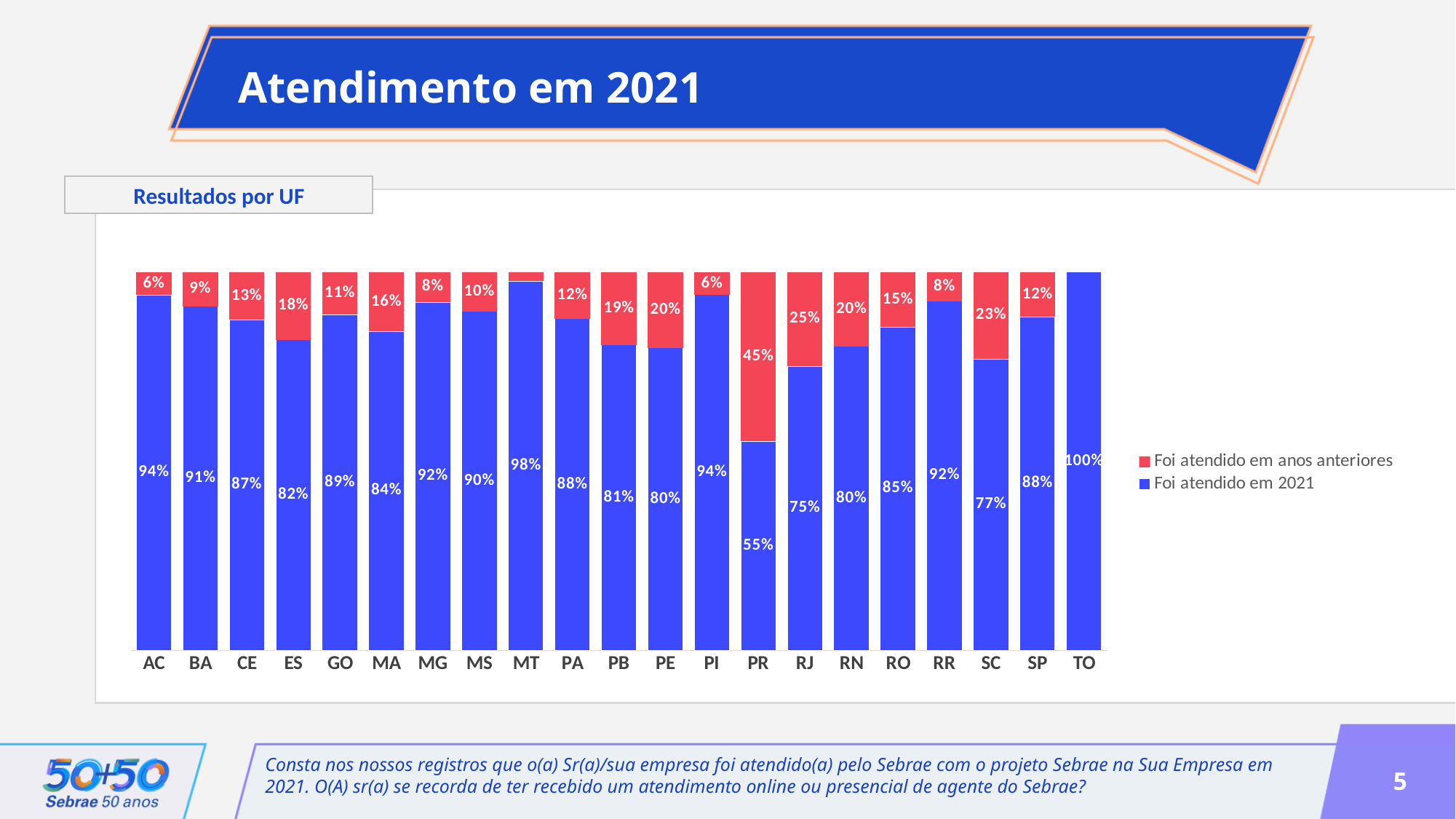
How many series does the legend list? 2 What percentage of respondents in PR were 'Foi atendido em 2021'? 55% Which UF has the lowest 'Foi atendido em 2021' value? PR What is the total of the stacked bar for PE? 100% How many UFs are shown on the x axis of the chart? 21 Which UF has the highest 'Foi atendido em 2021' value? TO Which UF has the highest 'Foi atendido em anos anteriores' value? PR What is the difference between the 'Foi atendido em 2021' values for AC and ES? 12% Which is larger, the 'Foi atendido em 2021' value for RJ or for RN? RN Which colour represents 'Foi atendido em 2021' in the chart? Blue What kind of chart is shown on the slide? Stacked bar chart What is the 'Foi atendido em anos anteriores' value for SC? 23%